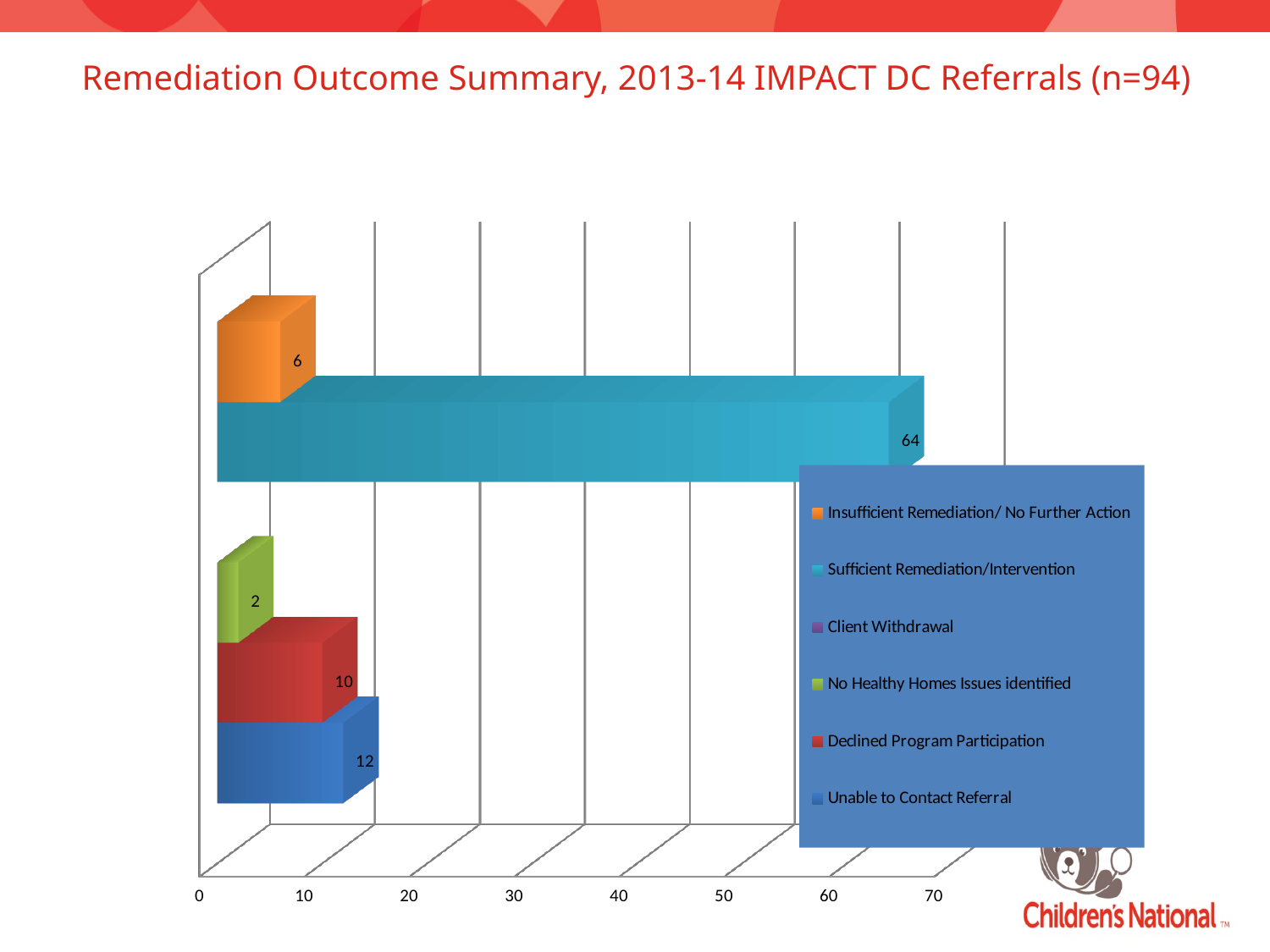
Which outcome category has the highest value? Sufficient Remediation/Intervention What is the difference between Unable to Contact Referral and Declined Program Participation? 2 What is the value for Insufficient Remediation/ No Further Action? 6 Which is larger, Declined Program Participation or Insufficient Remediation/ No Further Action? Declined Program Participation What is the value for Unable to Contact Referral? 12 What is the value for Declined Program Participation? 10 What is the difference between Sufficient Remediation/Intervention and Unable to Contact Referral? 52 What is the value for Sufficient Remediation/Intervention? 64 How many series does the legend list? 6 What is the value for No Healthy Homes Issues identified? 2 What kind of chart is shown on the slide? Bar chart Is the value for Sufficient Remediation/Intervention greater or less than 60? greater